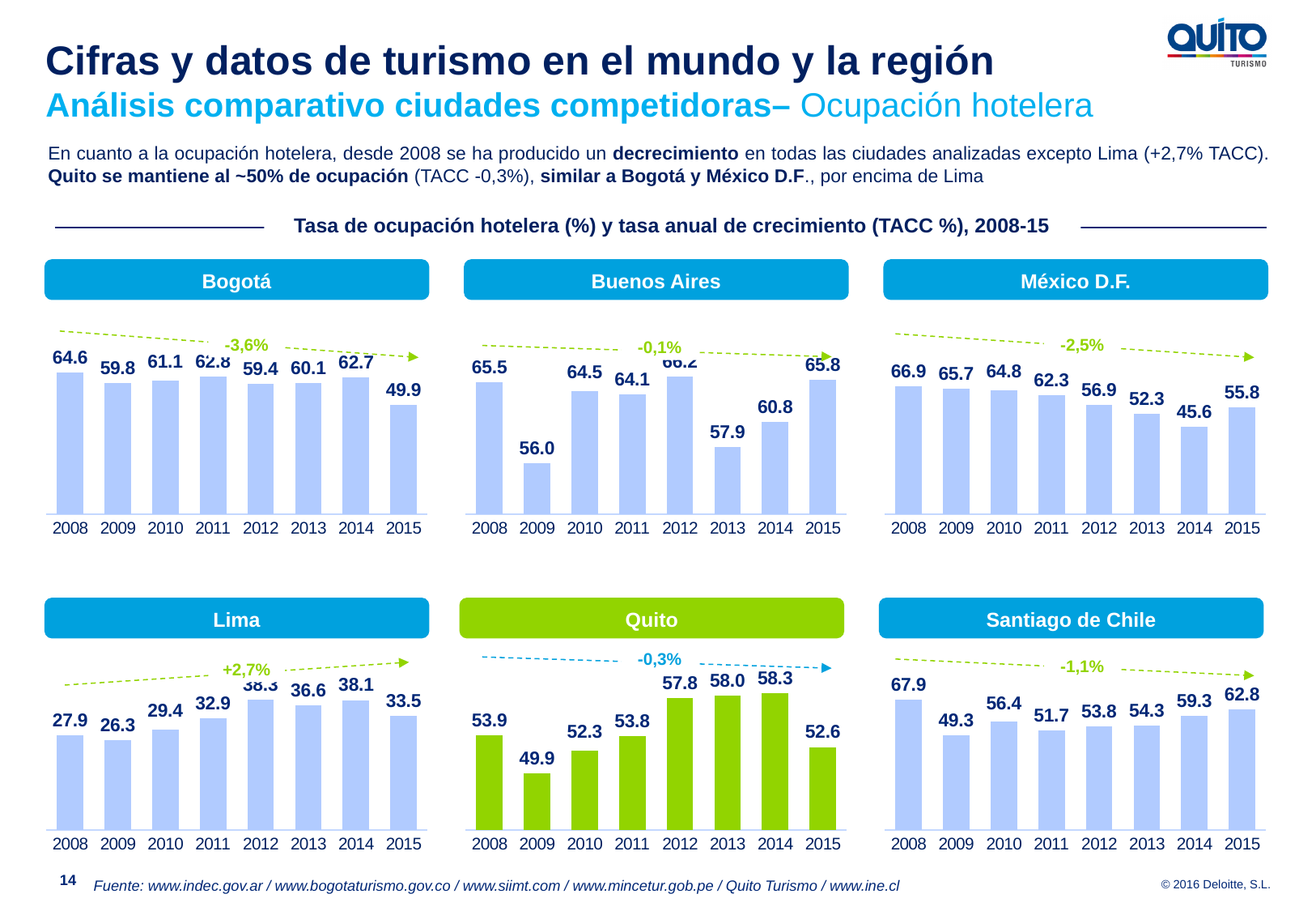
In the México D.F. chart, which year has the lowest occupancy rate? 2014 In the Santiago de Chile chart, which year has the larger value, 2008 or 2009? 2008 In the Buenos Aires chart, what is the value for 2009? 56.0 In the Quito chart, which year has the highest occupancy rate? 2014 In the México D.F. chart, do the values rise or fall from 2008 to 2014? Fall What kind of chart is used for the Quito data? Bar chart In the Bogotá chart, what is the hotel occupancy rate for 2015? 49.9 How many years are shown on the x axis of the Bogotá chart? 8 In the Santiago de Chile chart, which year has the highest value? 2008 In the Lima chart, what is the difference between the 2015 value and the 2008 value? 5.6 In the Lima chart, which year has the lowest value? 2009 What annual growth rate (TACC) is shown on the Quito chart? -0,3%